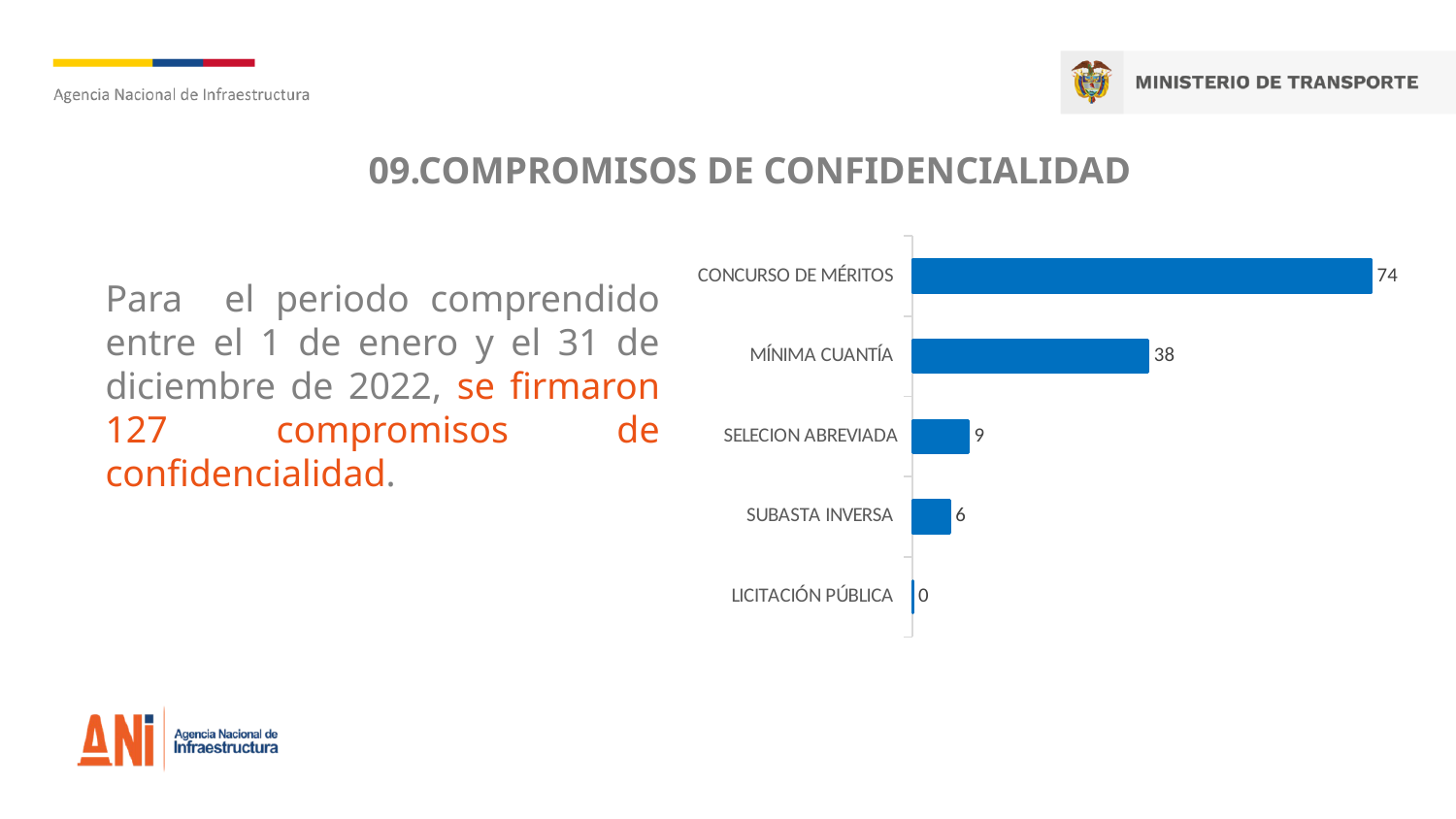
How many categories are shown in the chart? 5 What is the value for LICITACIÓN PÚBLICA? 0 Which category has the highest value? CONCURSO DE MÉRITOS What is the value for SELECION ABREVIADA? 9 What is the difference between the values for SELECION ABREVIADA and SUBASTA INVERSA? 3 What kind of chart is shown on the slide? Bar chart What is the value for SUBASTA INVERSA? 6 Which is larger, the value for SELECION ABREVIADA or the value for SUBASTA INVERSA? SELECION ABREVIADA What is the value for CONCURSO DE MÉRITOS? 74 Which category has the lowest value? LICITACIÓN PÚBLICA What is the value for MÍNIMA CUANTÍA? 38 What is the difference between the values for CONCURSO DE MÉRITOS and MÍNIMA CUANTÍA? 36